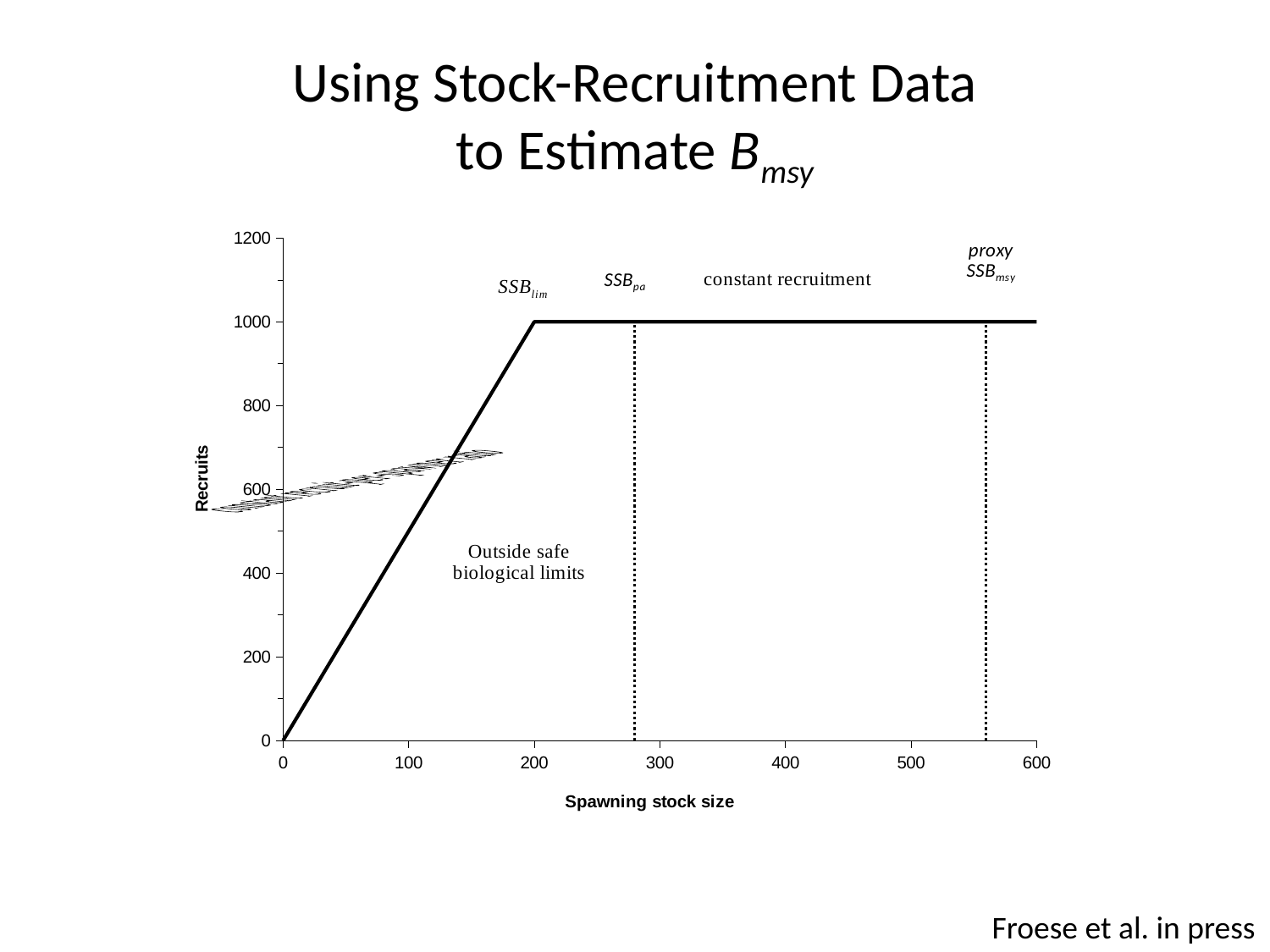
How do Recruits change as spawning stock size increases from 200 to 600? they stay constant What is the label of the x axis? Spawning stock size What is the value of Recruits at a spawning stock size of 0? 0 What is the value of Recruits at a spawning stock size of 600? 1000 What is the label of the y axis? Recruits What kind of chart is shown on the slide? line chart Is the spawning stock size marked by the dotted line labelled proxy SSB_msy greater or less than 500? greater What is the value of Recruits at a spawning stock size of 200, where the line reaches its plateau? 1000 Is the value of Recruits at a spawning stock size of 100 greater or less than 600? less Is the spawning stock size marked by the dotted line labelled SSB_pa greater or less than 300? less How do Recruits change as spawning stock size increases from 0 to 200? they rise